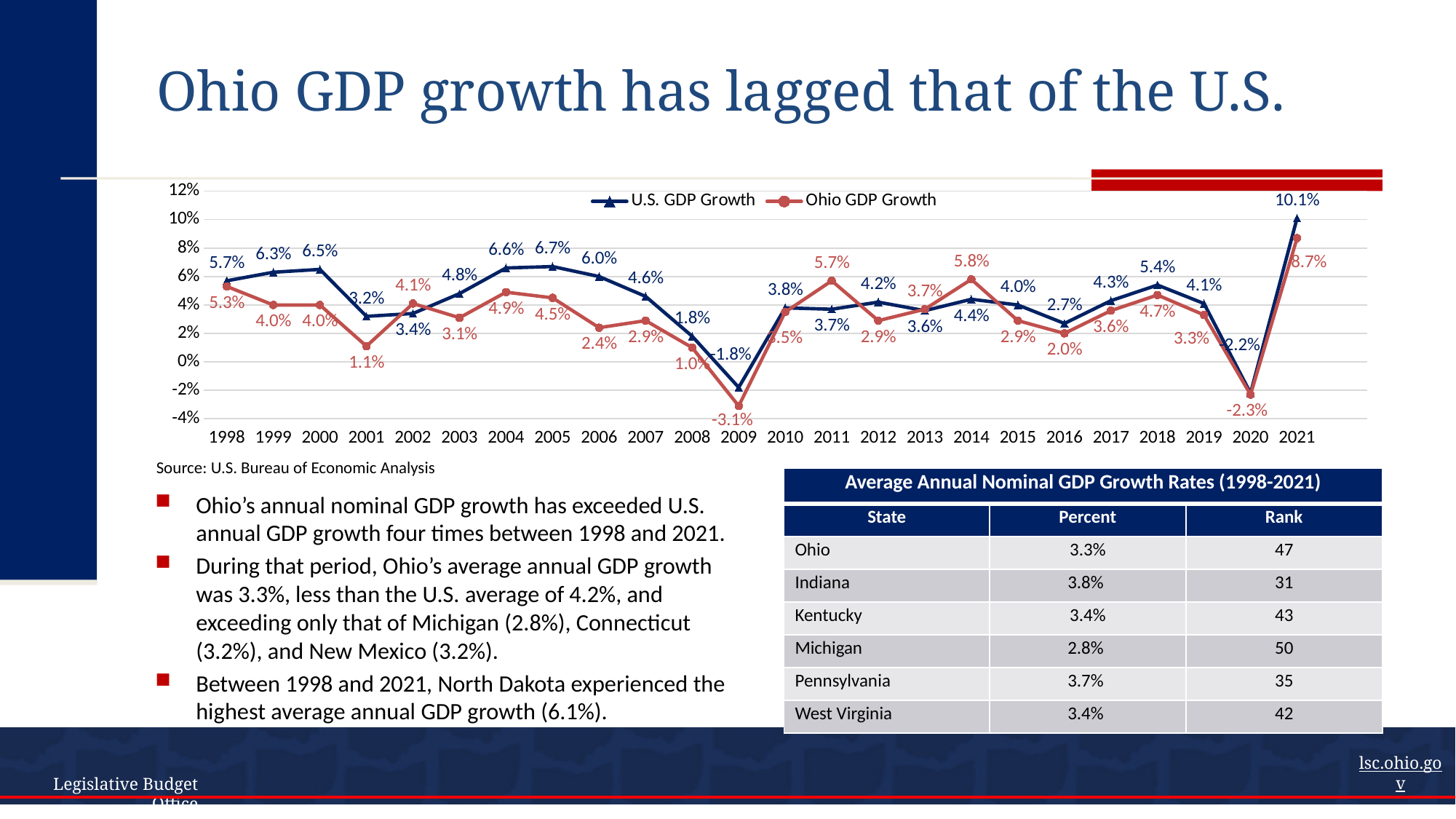
What was U.S. GDP Growth in 2021? 10.1% What is the source cited below the chart? U.S. Bureau of Economic Analysis How many series does the chart legend list? 2 In which year was U.S. GDP Growth highest? 2021 Which was larger in 2011, U.S. GDP Growth or Ohio GDP Growth? Ohio GDP Growth In which year was Ohio GDP Growth lowest? 2009 What type of chart is shown on the slide? Line chart What is the difference between U.S. GDP Growth and Ohio GDP Growth in 2001? 2.1% Did U.S. GDP Growth rise or fall from 2005 to 2009? Fall What was Ohio GDP Growth in 2009? -3.1% What was Ohio GDP Growth in 2014? 5.8% How many years are plotted along the x axis of the chart? 24